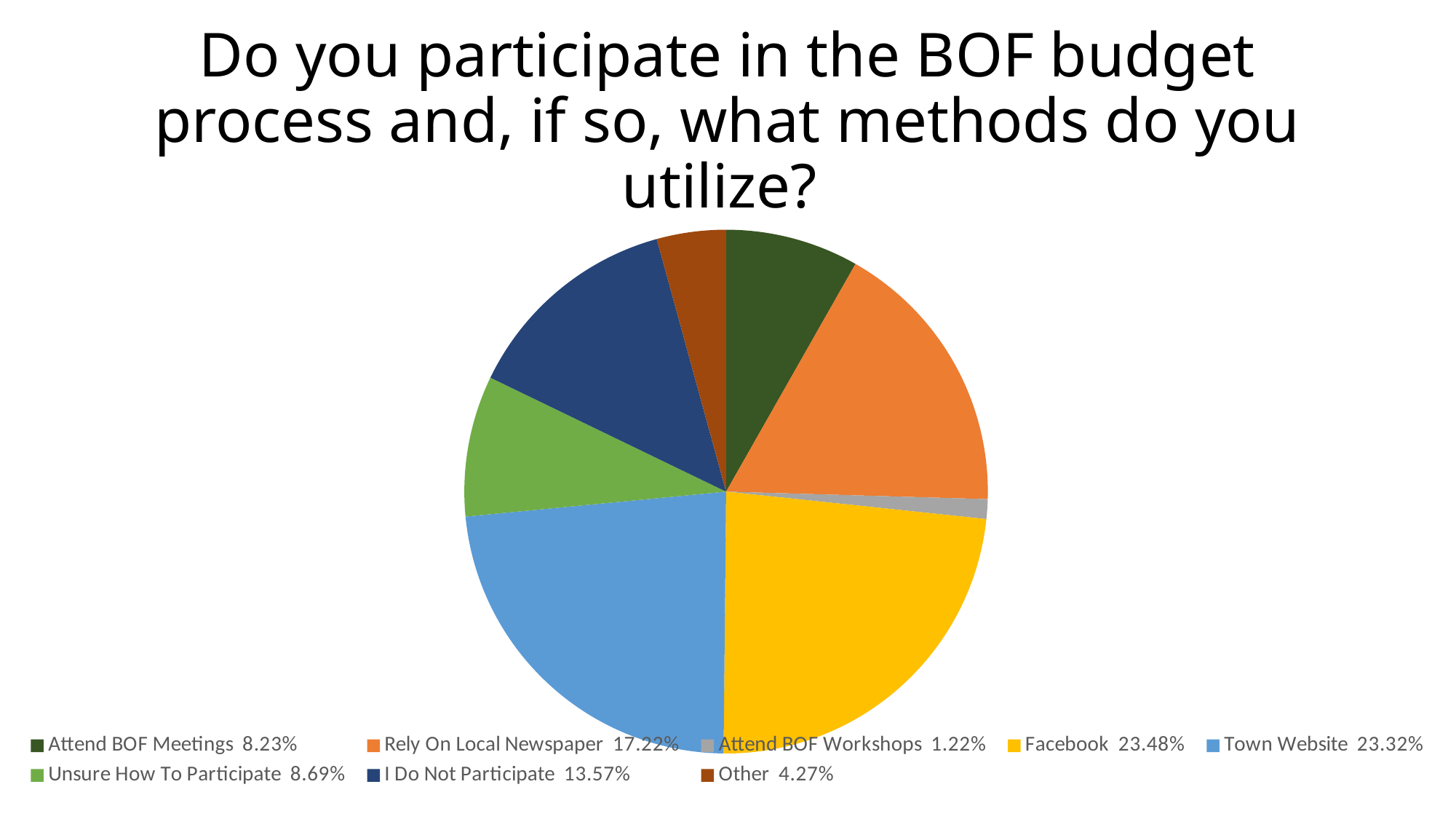
How many categories are shown in the pie chart? 8 What share of the pie does Town Website represent? 23.32% What is the value shown for I Do Not Participate? 13.57% What kind of chart is shown on the slide? Pie chart Which is larger, Unsure How To Participate or Other? Unsure How To Participate What is the difference between the Rely On Local Newspaper and I Do Not Participate percentages? 3.65% What colour is the Facebook slice? Yellow What is the difference between the Facebook and Town Website percentages? 0.16% Which category has the largest share of the pie? Facebook What percentage of respondents said they rely on the local newspaper? 17.22% Which category has the smallest share of the pie? Attend BOF Workshops What percentage is shown for Attend BOF Workshops? 1.22%